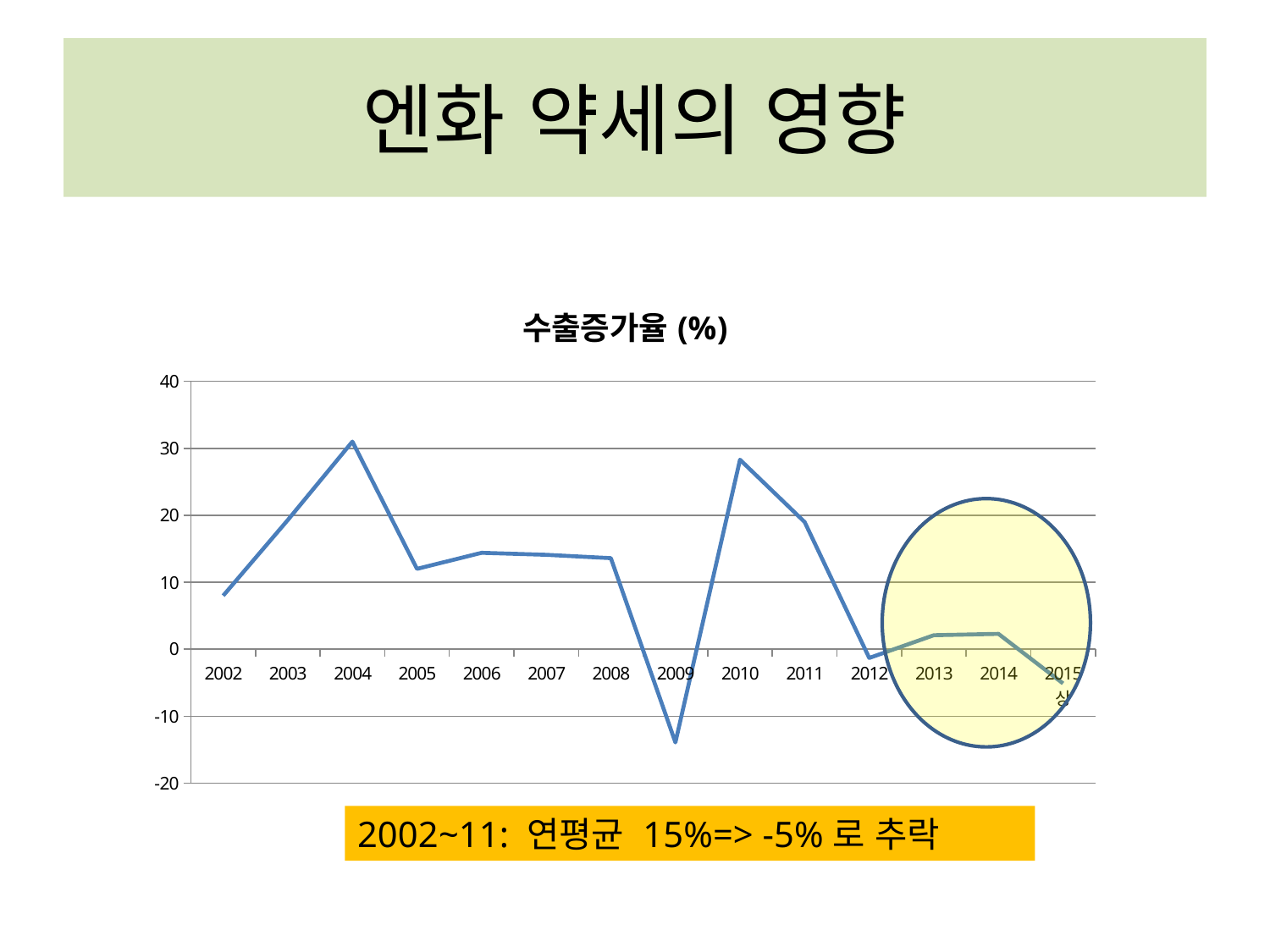
Which year has the larger export growth rate, 2004 or 2010? 2004 Is the value for 2009 greater or less than -10? less Is the value for 2004 greater or less than 20? greater What kind of chart is shown on the slide? line chart What is the title of the chart? 수출증가율 (%) Is the value for 2002 greater or less than 10? less Does the export growth rate rise or fall from 2010 to 2012? fall In which year is the export growth rate lowest? 2009 How many years (data points) are plotted on the x axis of the chart? 14 In which year is the export growth rate highest? 2004 Which year has the larger export growth rate, 2002 or 2005? 2005